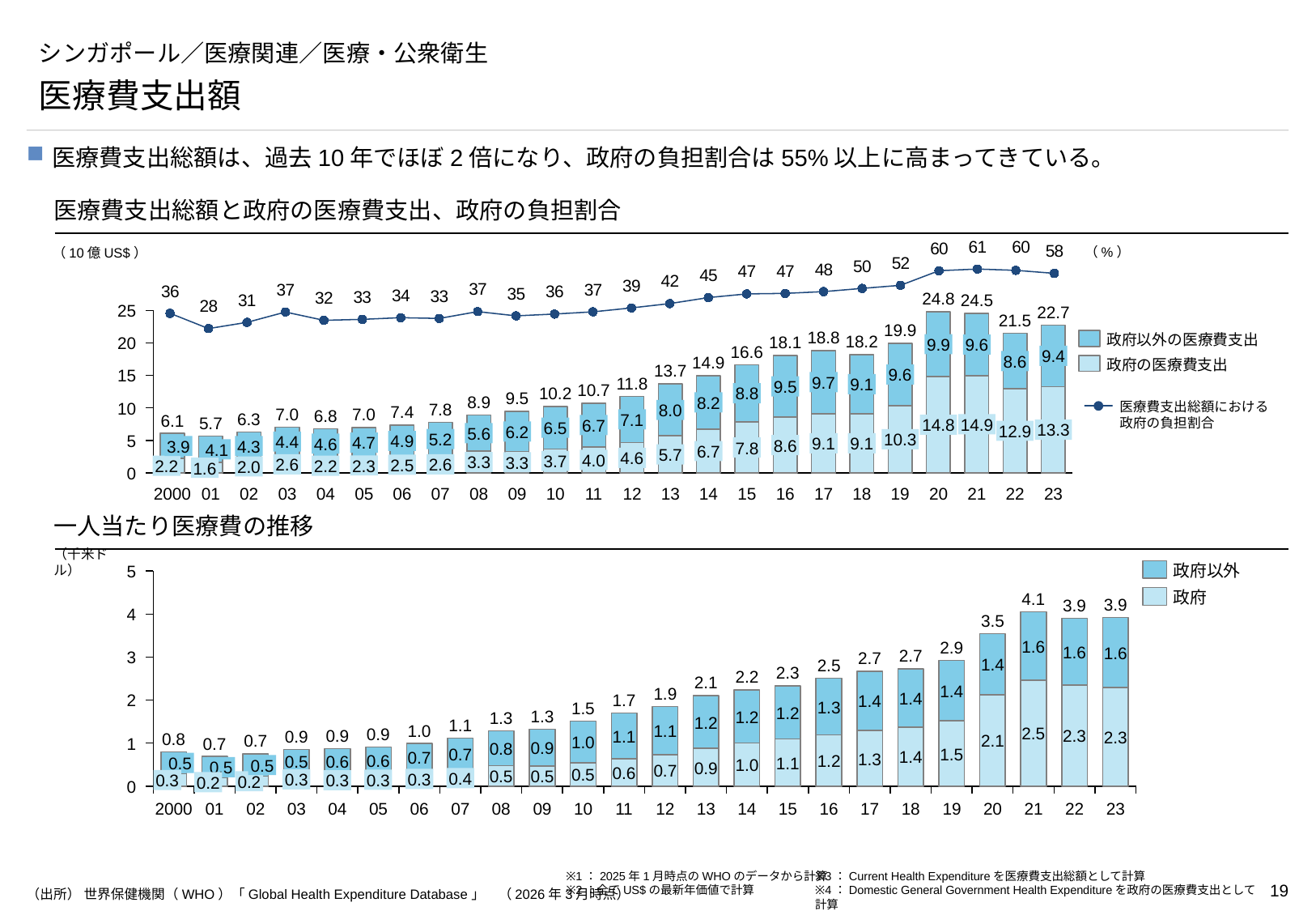
In the bottom chart (一人当たり医療費の推移), what is the total per-capita health expenditure for 2021? 4.1 In the top chart (医療費支出総額と政府の医療費支出、政府の負担割合), what is the total health expenditure shown for 2023? 22.7 In the bottom chart, what is the 政府 value for 2019? 1.5 In the bottom chart, how many years are plotted on the x axis? 24 In the top chart, what is the government health expenditure (政府の医療費支出) for 2020? 14.8 In the top chart, how many series does the legend list? 3 In the top chart, which year has the lowest government share on the line? 01 In the top chart, which year has the highest total health expenditure? 20 In the top chart, what is the government share (政府の負担割合) shown on the line for 2021? 61 In the top chart, what is the difference between the total health expenditure in 2023 and in 2000? 16.6 In the bottom chart, which year has the highest total per-capita health expenditure? 21 In the bottom chart, is the 政府以外 value larger in 2023 or in 2010? 2023